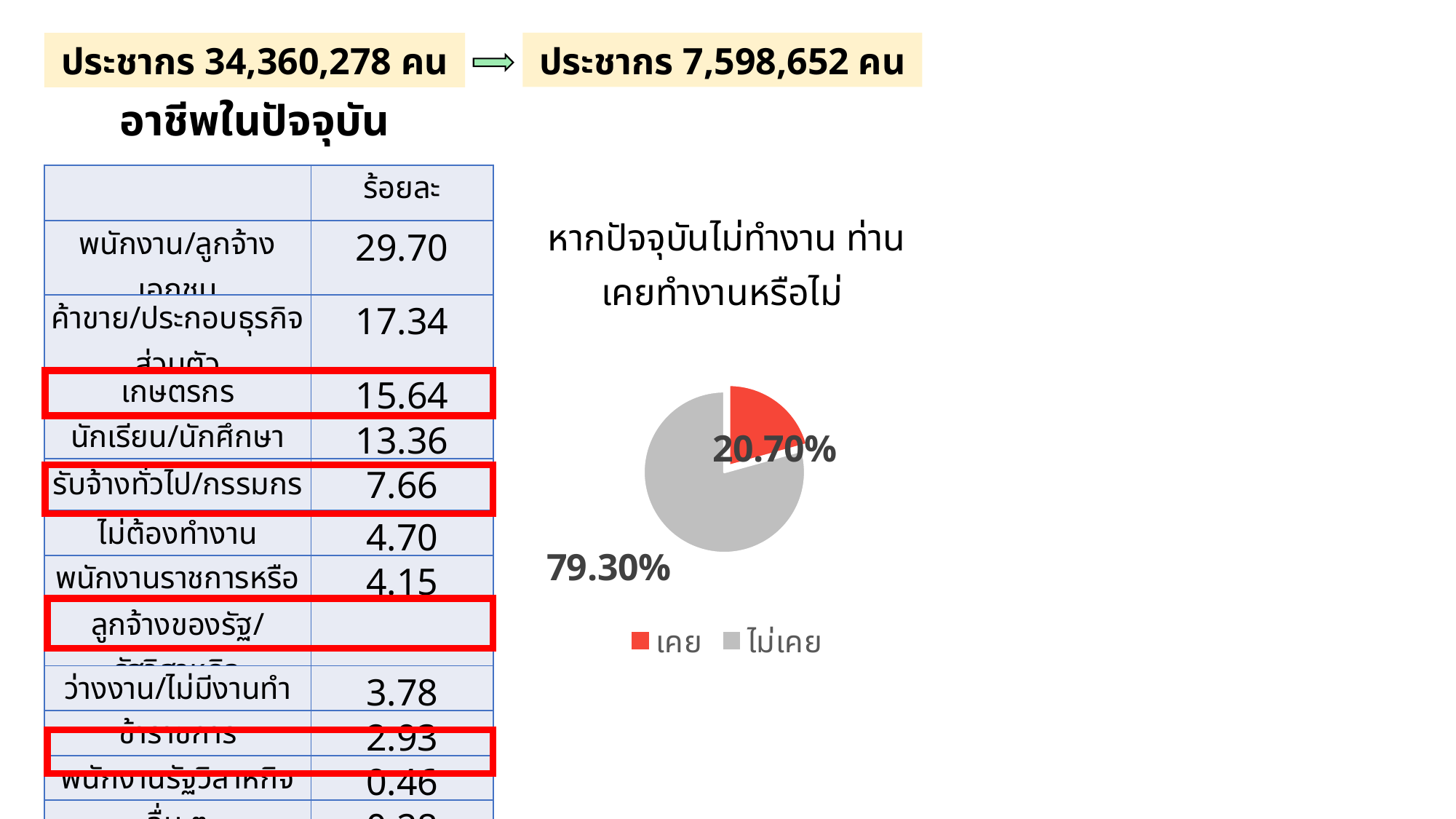
In the pie chart, what is the difference between the ไม่เคย share and the เคย share? 58.60% In the pie chart, which category has the largest slice? ไม่เคย In the pie chart, what percentage is shown for เคย? 20.70% In the pie chart, which category has the smallest slice? เคย How many entries does the pie chart's legend list? 2 How many slices does the pie chart have? 2 In the pie chart, what colour is the เคย slice? Red What is the title of the pie chart? หากปัจจุบันไม่ทำงาน ท่านเคยทำงานหรือไม่ In the pie chart, what share of the pie does the เคย slice represent? 20.70% What kind of chart is shown on the right side of the slide? Pie chart In the pie chart, which is larger: เคย or ไม่เคย? ไม่เคย In the pie chart, what percentage is shown for ไม่เคย? 79.30%